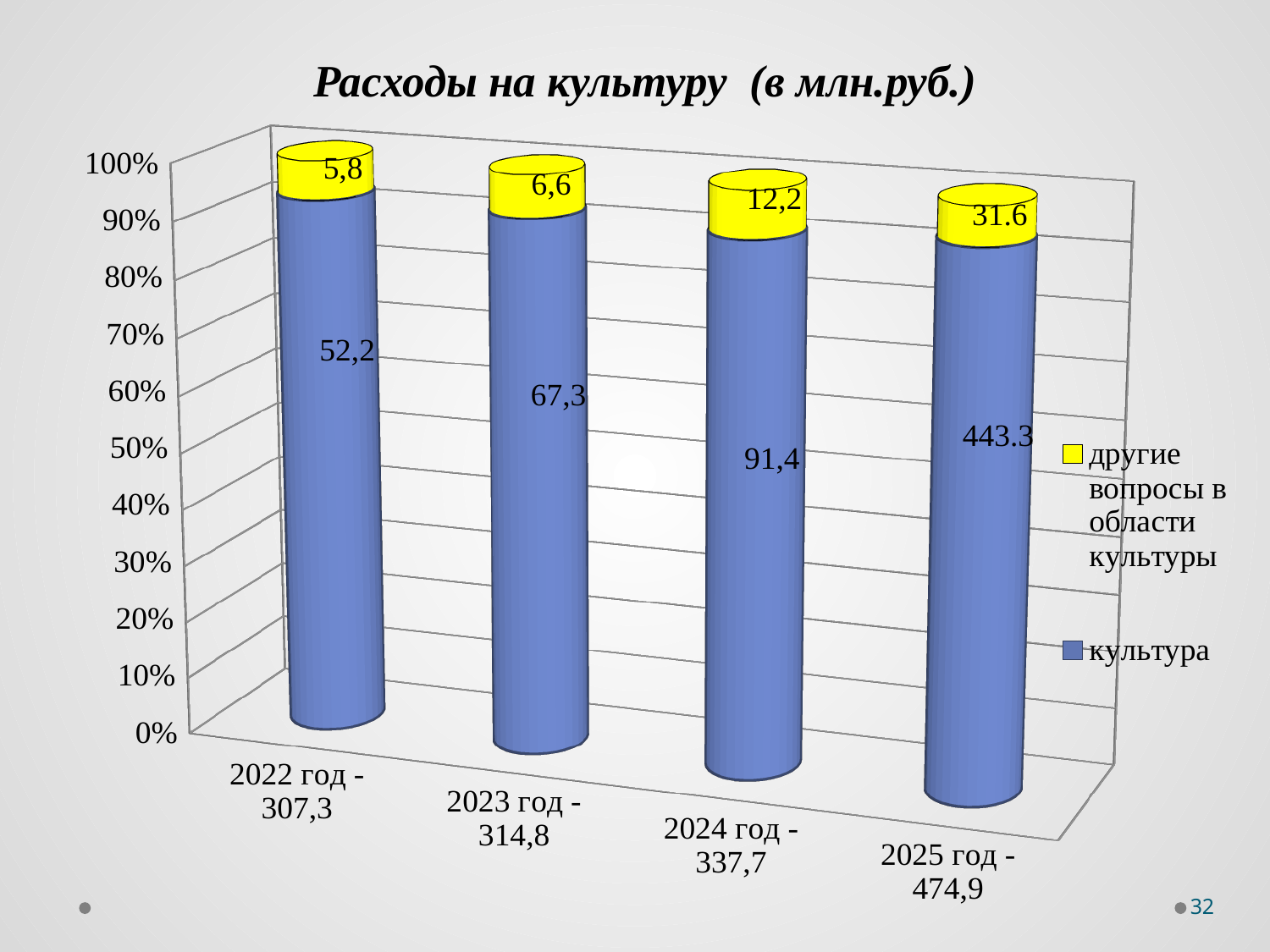
Which year has the highest value for the 'культура' series? 2025 год What is the title of the chart? Расходы на культуру (в млн.руб.) What is the value of the 'другие вопросы в области культуры' series for 2024 год? 12,2 Which year has the lowest value for the 'другие вопросы в области культуры' series? 2022 год What kind of chart is shown on the slide? Stacked bar chart Which is larger: the 'другие вопросы в области культуры' value for 2025 год or for 2024 год? 2025 год What is the value of the 'культура' series for 2025 год? 443.3 How many years (categories) are shown on the x axis? 4 What is the difference between the 'культура' values for 2024 год and 2023 год? 24,1 What is the value of the 'культура' series for 2022 год? 52,2 What is the value of the 'другие вопросы в области культуры' series for 2023 год? 6,6 How many series does the legend list? 2